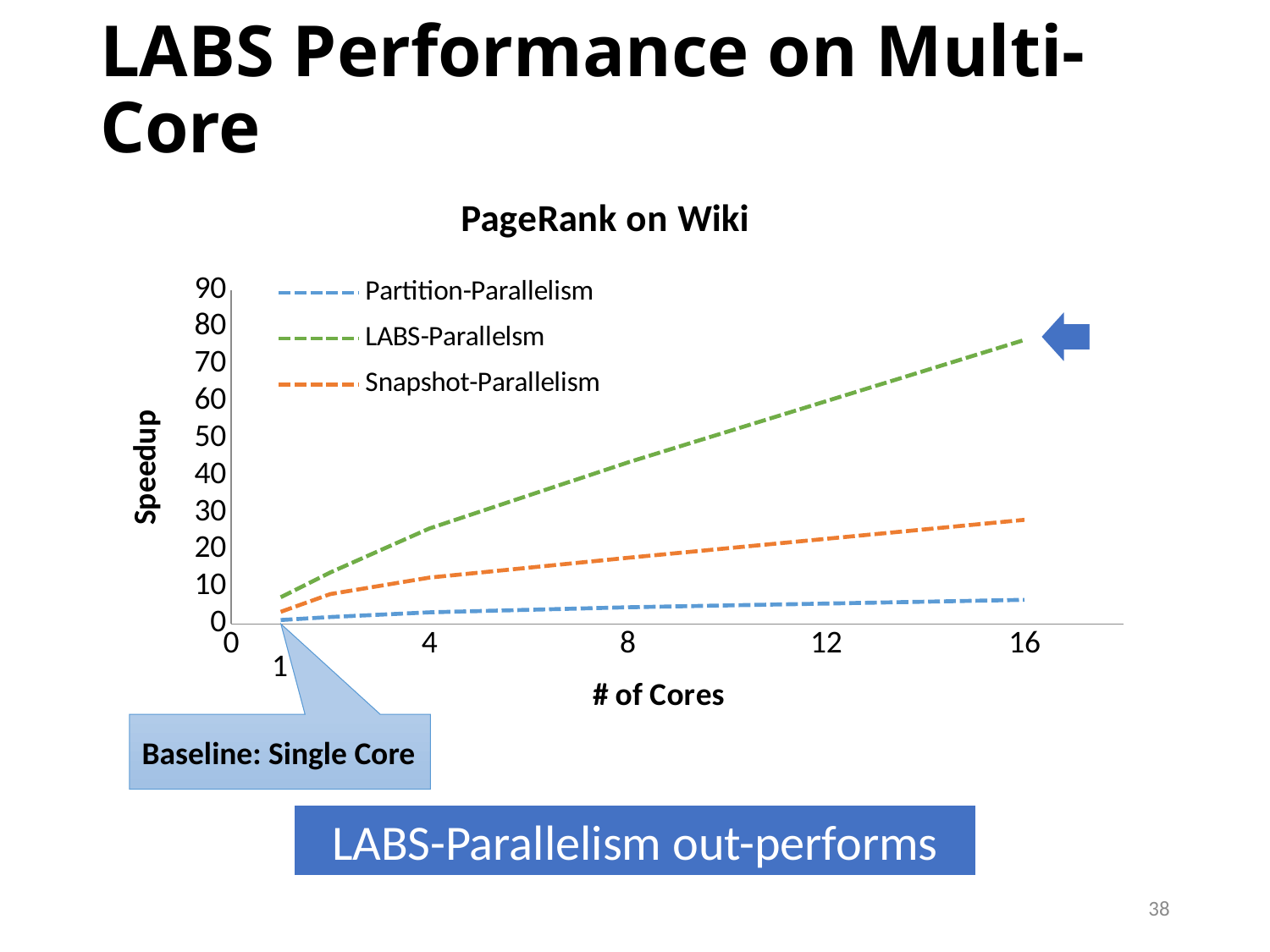
Is the speedup for LABS-Parallelsm at 16 cores greater or less than 70? greater Is the speedup for Partition-Parallelism at 16 cores greater or less than 10? less Which series has the highest speedup at 16 cores? LABS-Parallelsm What kind of chart is shown on the slide? line chart At 16 cores, which has the larger speedup: Snapshot-Parallelism or Partition-Parallelism? Snapshot-Parallelism Which series has the lowest speedup at 16 cores? Partition-Parallelism How many series does the legend list? 3 Does the speedup for LABS-Parallelsm rise or fall as the number of cores increases? rise What is the label of the y axis? Speedup What is the title of the chart? PageRank on Wiki Is the speedup for Snapshot-Parallelism at 16 cores greater or less than 20? greater